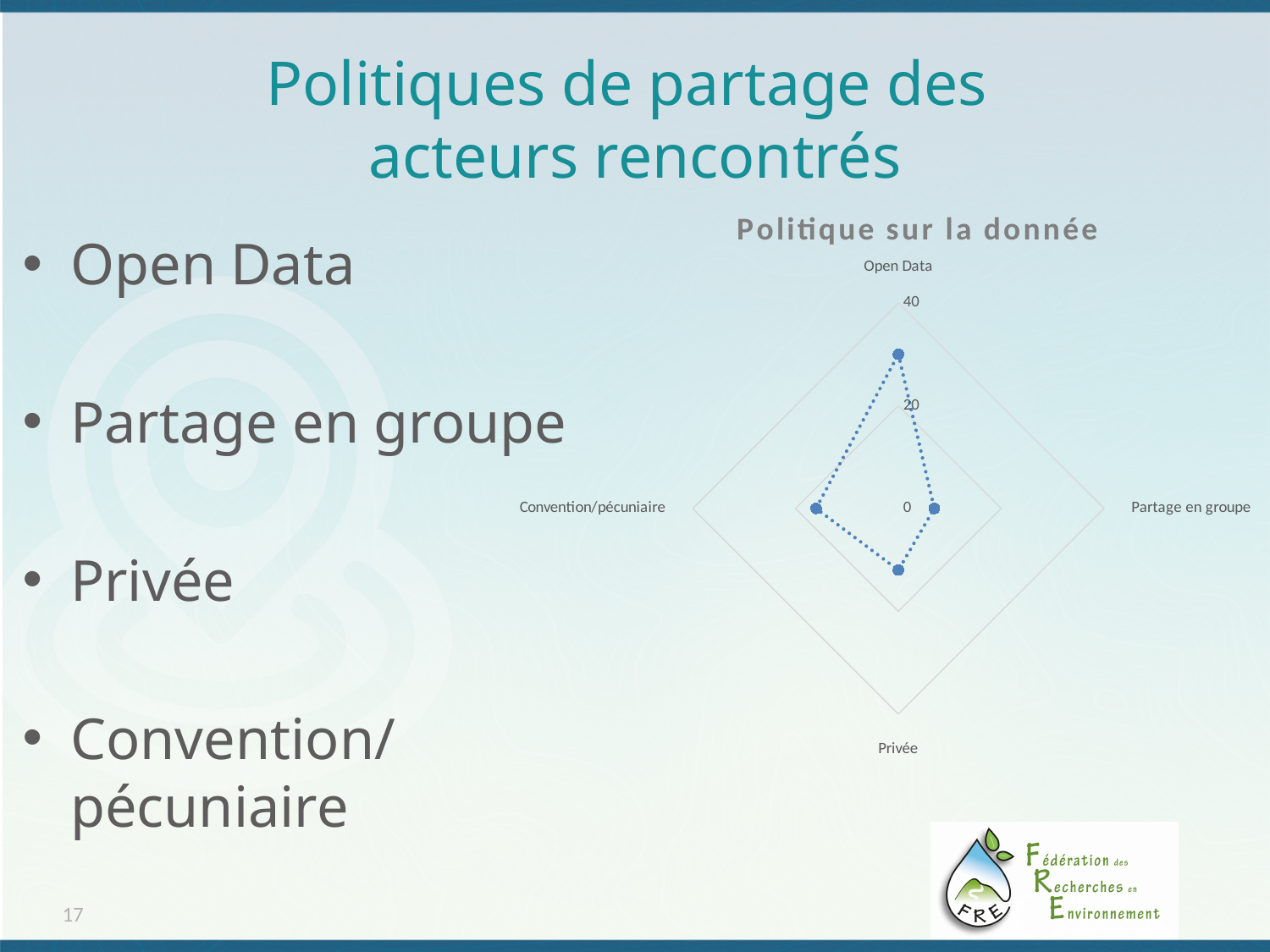
Which is larger, the value for Open Data or the value for Privée? Open Data Is the value for Open Data greater or less than 20? greater Is the value for Open Data greater or less than 40? less What kind of chart is shown on the slide? Radar chart Is the value for Privée greater or less than 20? less Which is larger, the value for Convention/pécuniaire or the value for Partage en groupe? Convention/pécuniaire Which category has the lowest value in the chart? Partage en groupe Which category has the highest value in the chart? Open Data What is the title of the chart? Politique sur la donnée How many categories (axes) does the radar chart have? 4